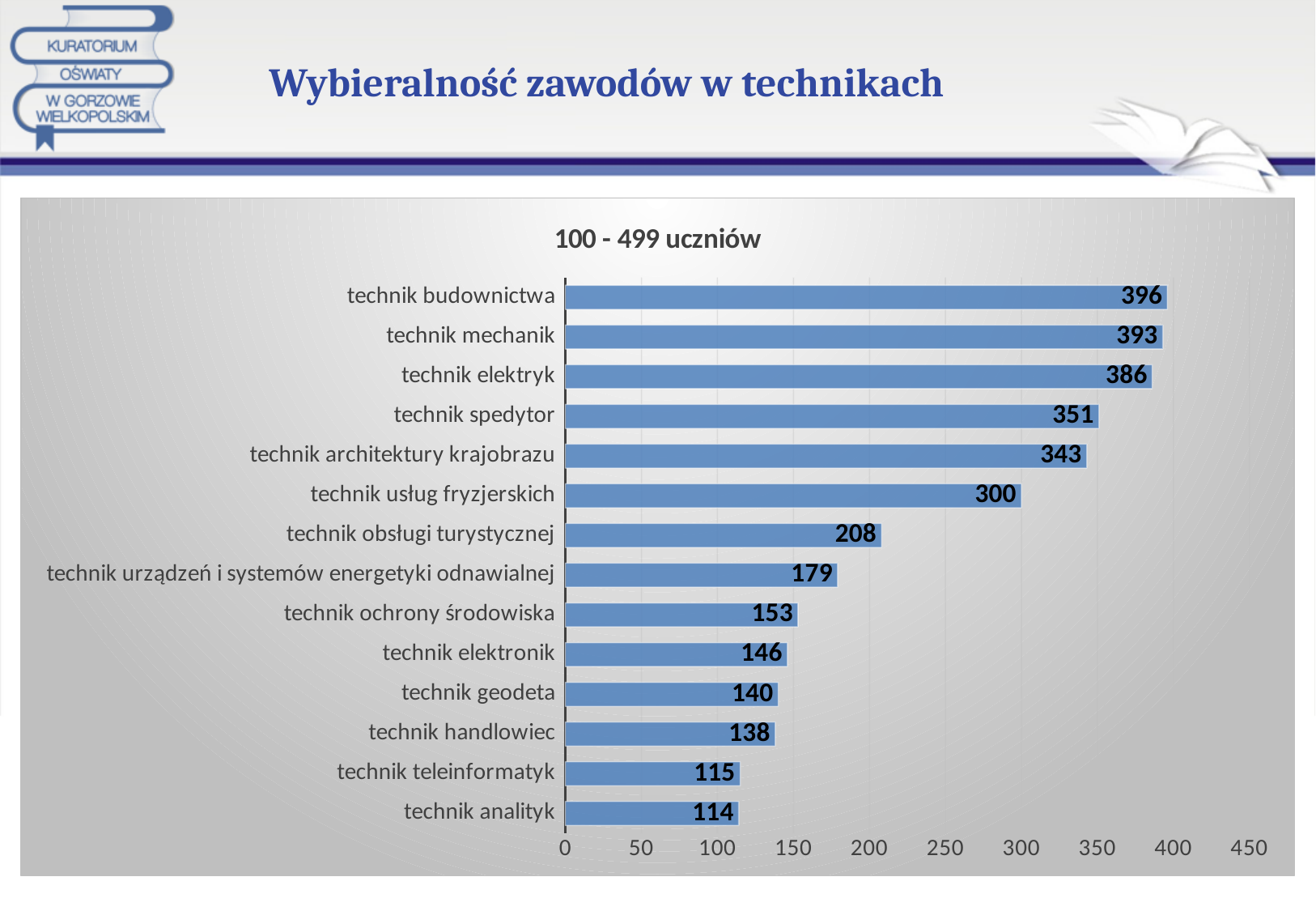
What is the title of the chart? 100 - 499 uczniów Which category has the highest value? technik budownictwa How many categories are shown in the chart? 14 What is the value for technik urządzeń i systemów energetyki odnawialnej? 179 Which category has the lowest value? technik analityk Which is larger, the value for technik elektryk or the value for technik architektury krajobrazu? technik elektryk What is the difference between the values for technik spedytor and technik obsługi turystycznej? 143 What kind of chart is shown on the slide? bar chart What is the value for technik usług fryzjerskich? 300 What is the value for technik budownictwa? 396 What is the difference between the values for technik geodeta and technik handlowiec? 2 Is the value for technik ochrony środowiska greater or less than 200? less